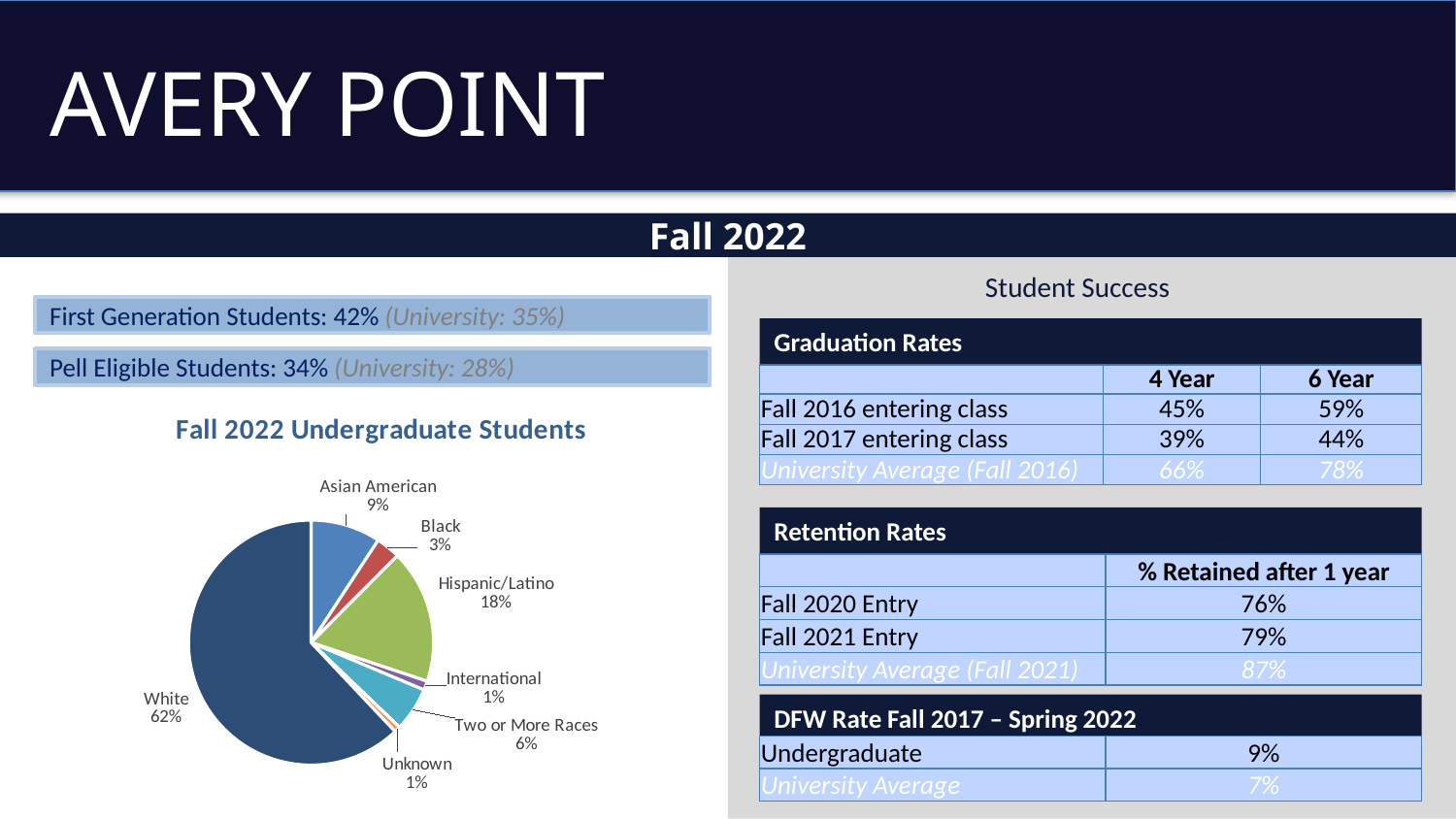
What share of Fall 2022 undergraduate students is Hispanic/Latino? 18% What share of Fall 2022 undergraduate students is Two or More Races? 6% Which slice is larger, Asian American or Two or More Races? Asian American What share of Fall 2022 undergraduate students is Black? 3% What kind of chart is shown on the slide? pie chart What share of Fall 2022 undergraduate students is White? 62% What share of Fall 2022 undergraduate students is Asian American? 9% What is the title of the pie chart? Fall 2022 Undergraduate Students What is the difference in percentage points between the White and Hispanic/Latino slices? 44 How many categories are shown in the pie chart? 7 What share of Fall 2022 undergraduate students is International? 1% Which category has the largest slice of the pie chart? White